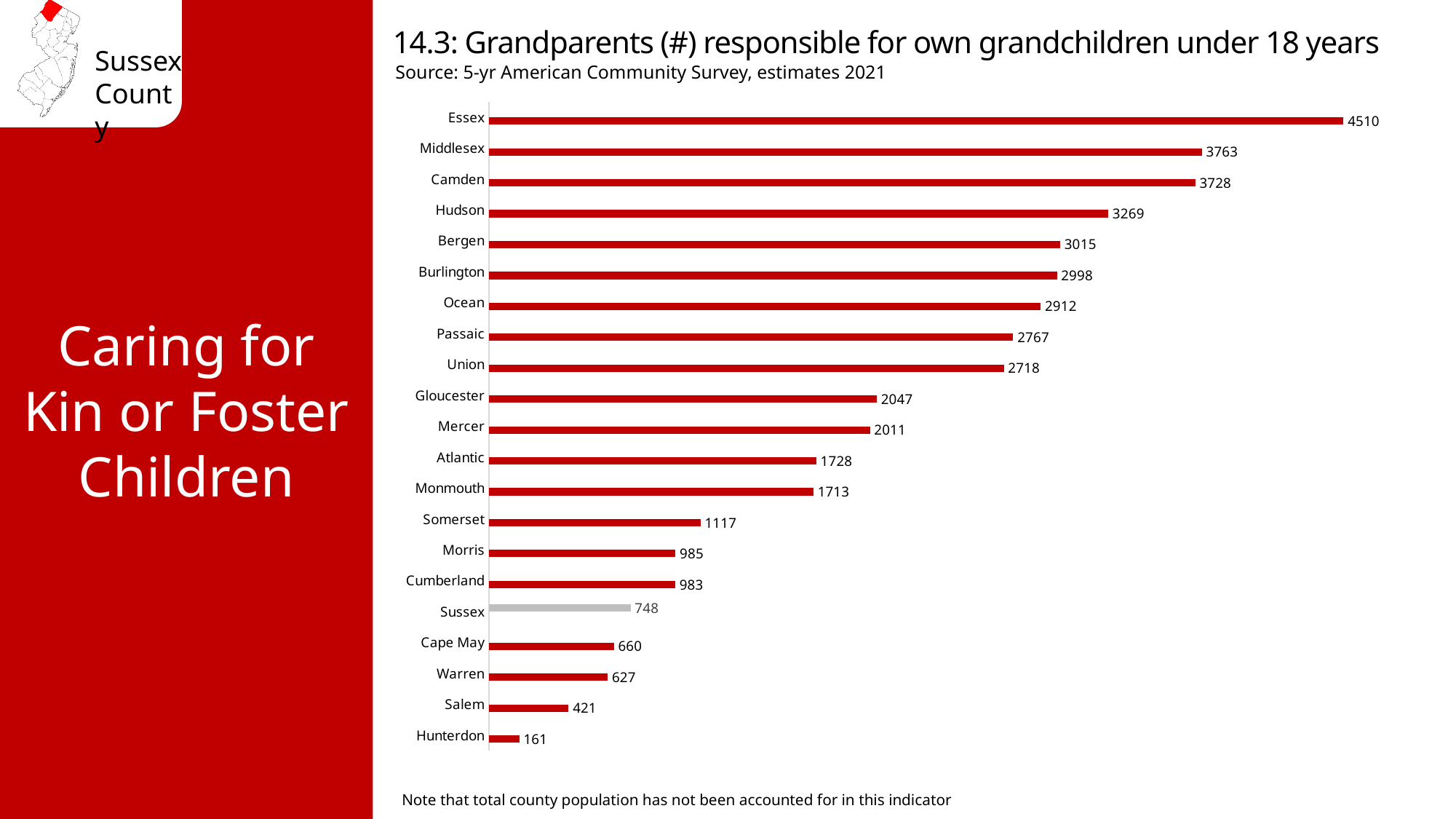
How many counties are shown in the chart? 21 What is the value for Cape May? 660 Which is larger, the value for Gloucester or the value for Somerset? Gloucester What is the value for Hudson? 3269 Which county has the highest value? Essex What kind of chart is shown on the slide? Bar chart Which is larger, the value for Bergen or the value for Burlington? Bergen What is the difference between the values for Essex and Middlesex? 747 What is the difference between the values for Sussex and Hunterdon? 587 Which county has the lowest value? Hunterdon What is the value for Sussex? 748 Which county's bar is shown in grey rather than red? Sussex